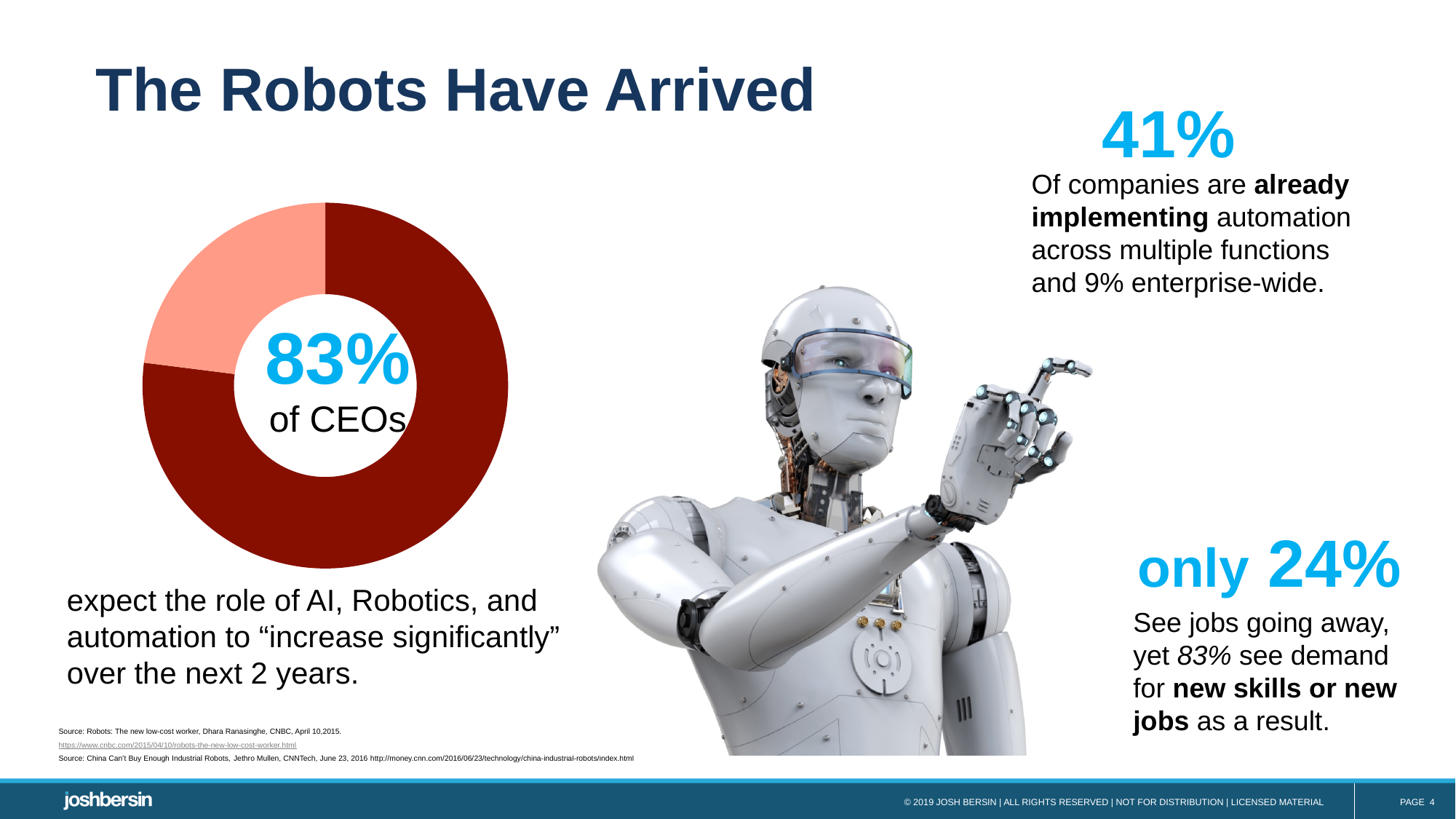
What percentage is printed in the centre of the donut chart? 83% How many slices does the donut chart have? 2 What kind of chart is shown on the left of the slide? pie chart (donut) Who does the 83% in the donut chart refer to? CEOs Is the share of the dark red slice in the donut chart greater or less than 50%? greater Which slice of the donut chart is larger, the dark red one or the light salmon one? the dark red one What colour is the larger slice of the donut chart? dark red